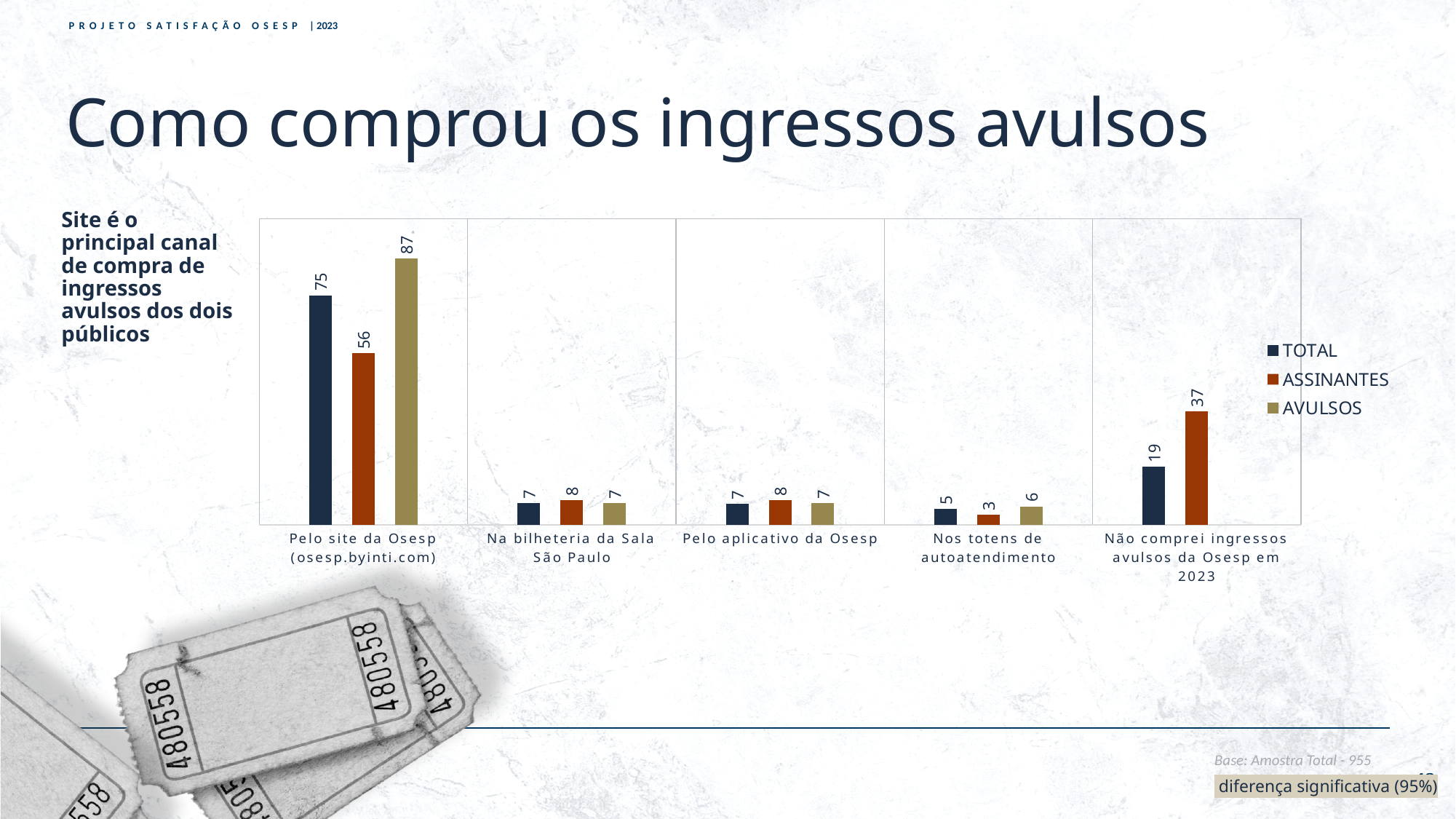
For 'Pelo site da Osesp (osesp.byinti.com)', which is larger: the ASSINANTES value or the AVULSOS value? AVULSOS What is the AVULSOS value for 'Pelo site da Osesp (osesp.byinti.com)'? 87 What is the ASSINANTES value for 'Não comprei ingressos avulsos da Osesp em 2023'? 37 What is the difference between the ASSINANTES and TOTAL values for 'Não comprei ingressos avulsos da Osesp em 2023'? 18 How many categories are shown on the x axis? 5 Which category has the highest TOTAL value? Pelo site da Osesp (osesp.byinti.com) Which category has the lowest ASSINANTES value? Nos totens de autoatendimento What is the TOTAL value for 'Pelo site da Osesp (osesp.byinti.com)'? 75 What is the difference between the AVULSOS and ASSINANTES values for 'Pelo site da Osesp (osesp.byinti.com)'? 31 How many series does the legend list? 3 What kind of chart is shown on the slide? Bar chart What is the ASSINANTES value for 'Nos totens de autoatendimento'? 3